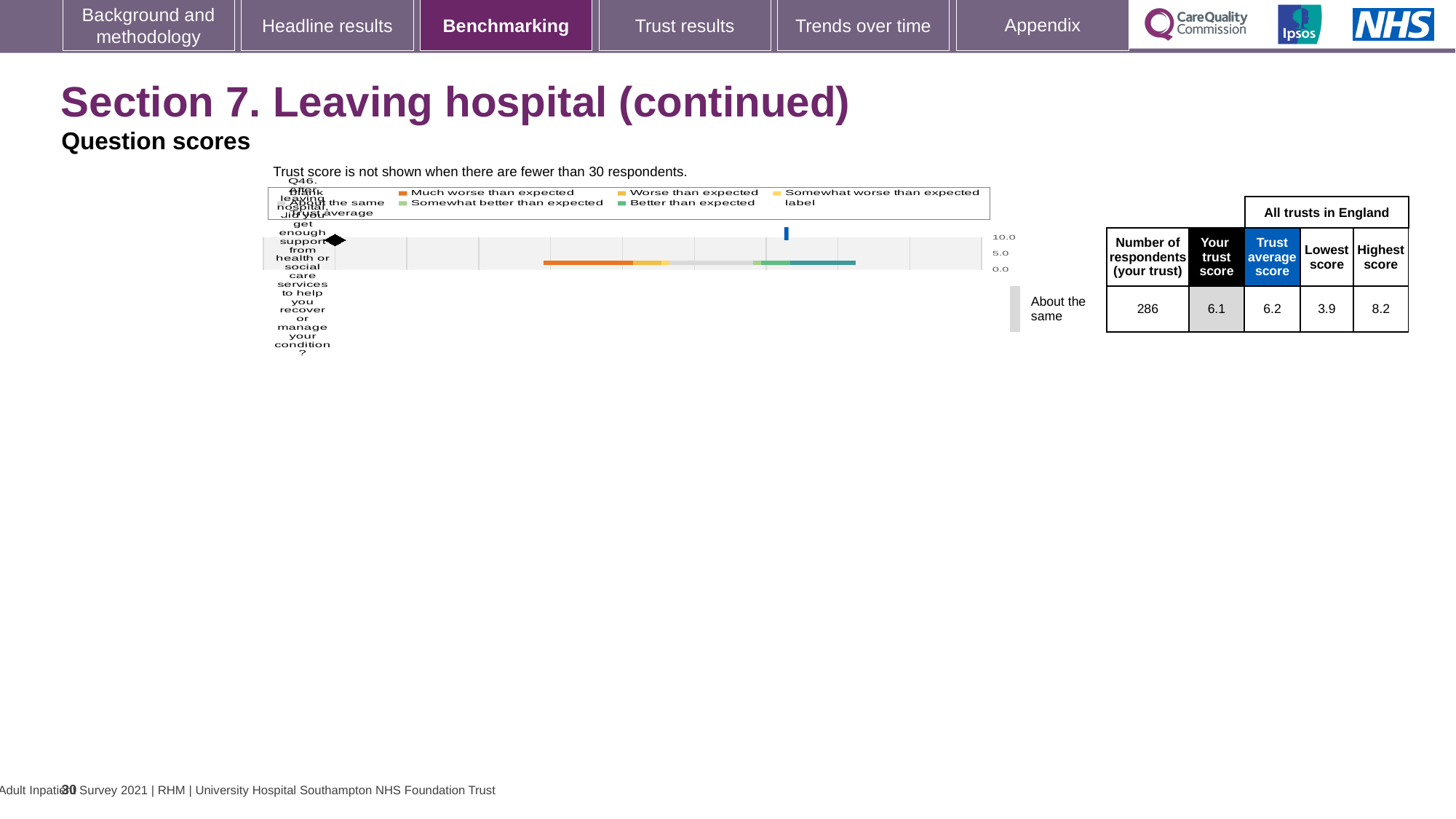
According to the slide, how many respondents answered Q46 for this trust? 286 What is the difference between the highest score and the lowest score for Q46? 4.3 According to the slide, what is the lowest score among all trusts in England for Q46? 3.9 How many question categories are plotted on the chart? 1 What is the highest value shown on the chart's axis? 10.0 According to the slide, what is the highest score among all trusts in England for Q46? 8.2 What kind of chart is shown on the slide? bar chart According to the slide, what is the trust average score for Q46? 6.2 Which question number is plotted on the chart? Q46 Which is larger for Q46, the trust score or the trust average score? Trust average score According to the slide, what is the trust score for Q46? 6.1 What benchmark category is the trust's Q46 score placed in? About the same